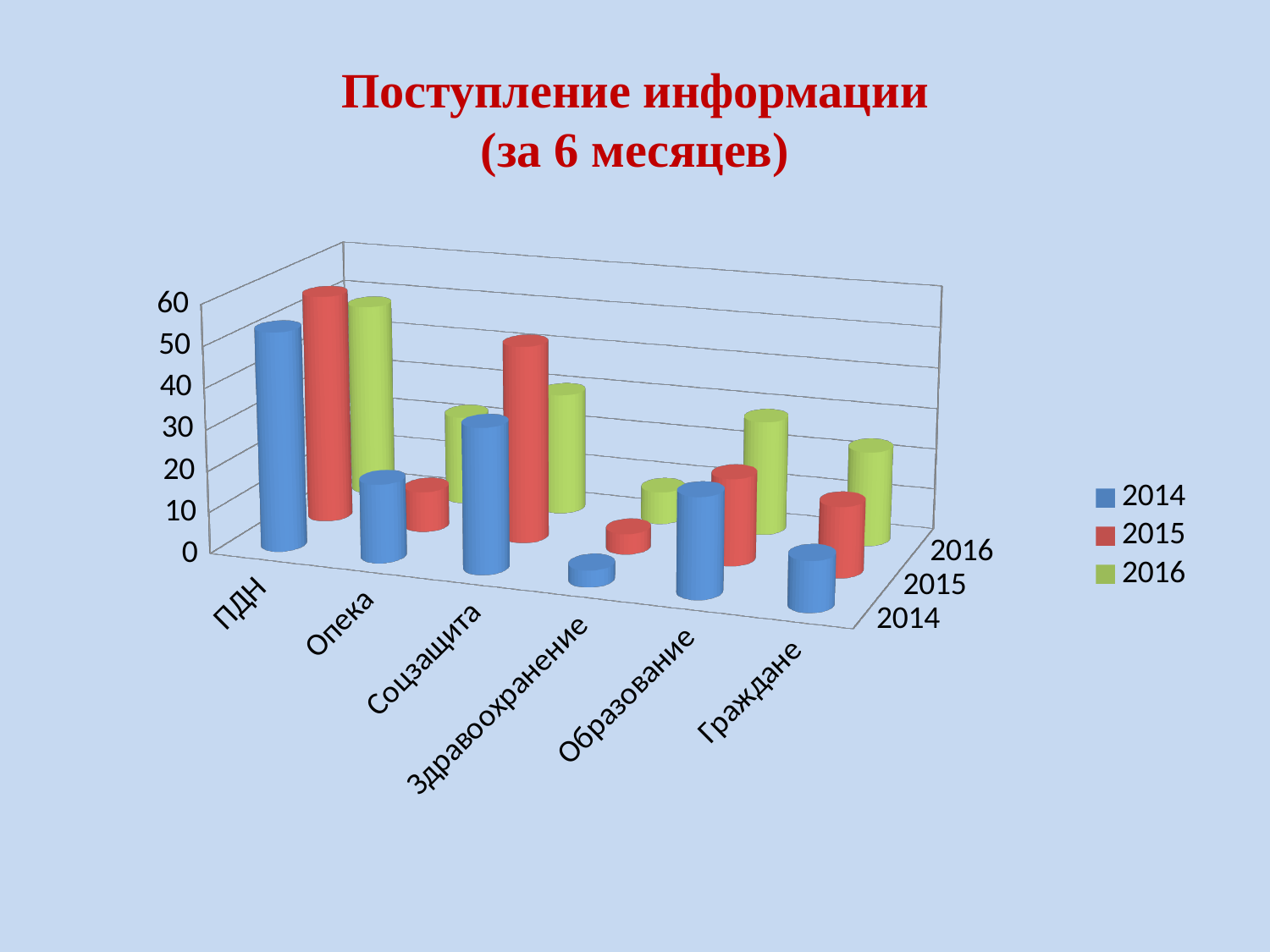
Is the 2014 value for ПДН greater or less than 40? greater Which colour represents the 2015 series in the legend? red How many categories are shown on the x axis of the chart? 6 For Соцзащита, which is larger: the 2014 value or the 2015 value? 2015 Which category has the lowest value for the 2014 series? Здравоохранение Which category has the highest value for the 2014 series? ПДН How many series does the legend list? 3 What kind of chart is shown on the slide? bar chart Which category has the lowest value for the 2016 series? Здравоохранение What is the title of the chart? Поступление информации (за 6 месяцев) Which category has the highest value for the 2015 series? ПДН Is the 2014 value for Здравоохранение greater or less than 10? less